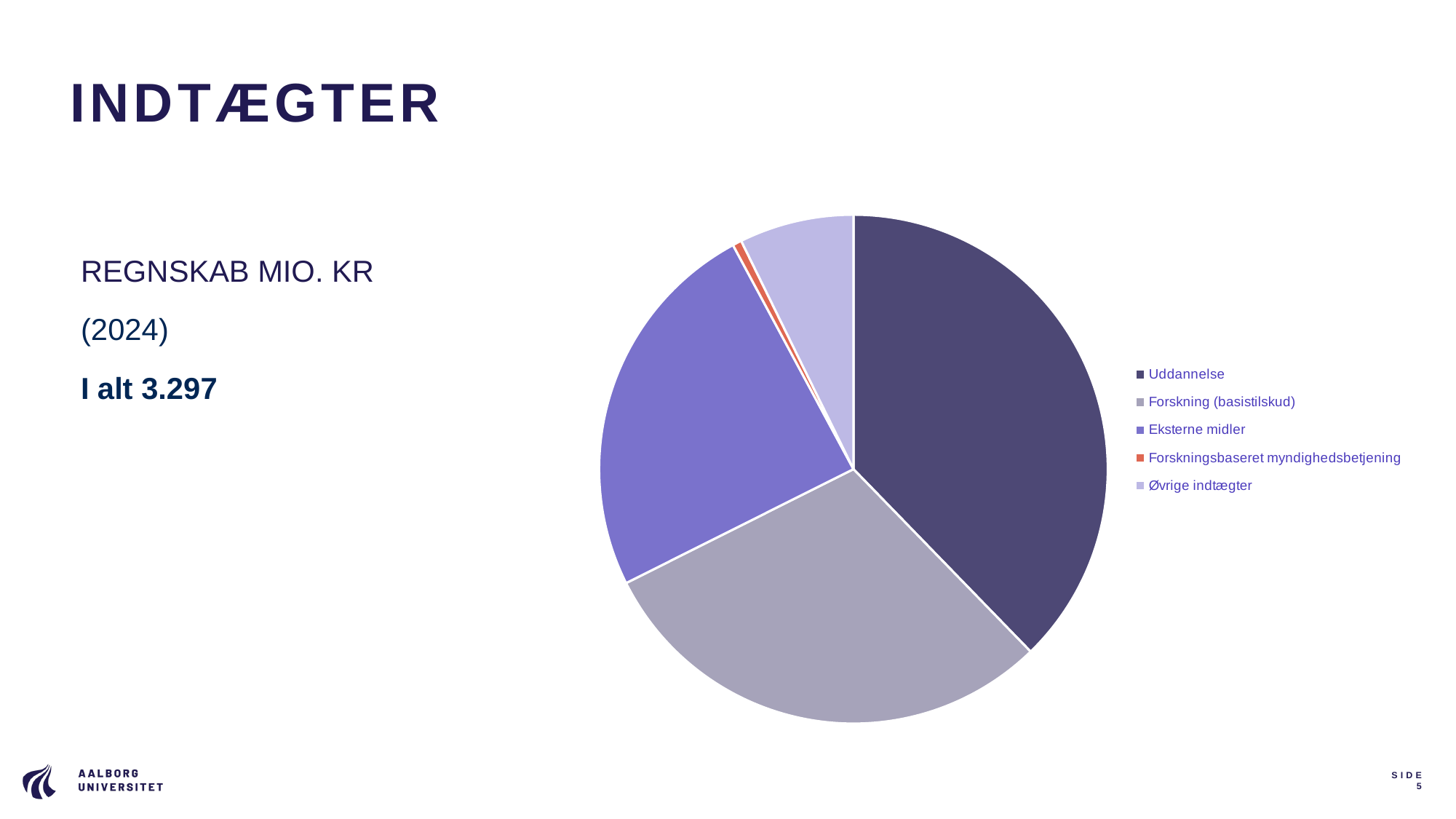
Which slice is larger, Forskning (basistilskud) or Eksterne midler? Forskning (basistilskud) What total amount is stated on the slide for the income shown in the pie chart? 3.297 Which slice is larger, Uddannelse or Forskning (basistilskud)? Uddannelse How many entries does the legend of the pie chart list? 5 Which slice is larger, Uddannelse or Øvrige indtægter? Uddannelse How many slices does the pie chart have? 5 What kind of chart is shown on the slide? Pie chart Which category has the smallest slice of the pie chart? Forskningsbaseret myndighedsbetjening Which category has the largest slice of the pie chart? Uddannelse Which legend entry of the pie chart is shown in red/orange? Forskningsbaseret myndighedsbetjening